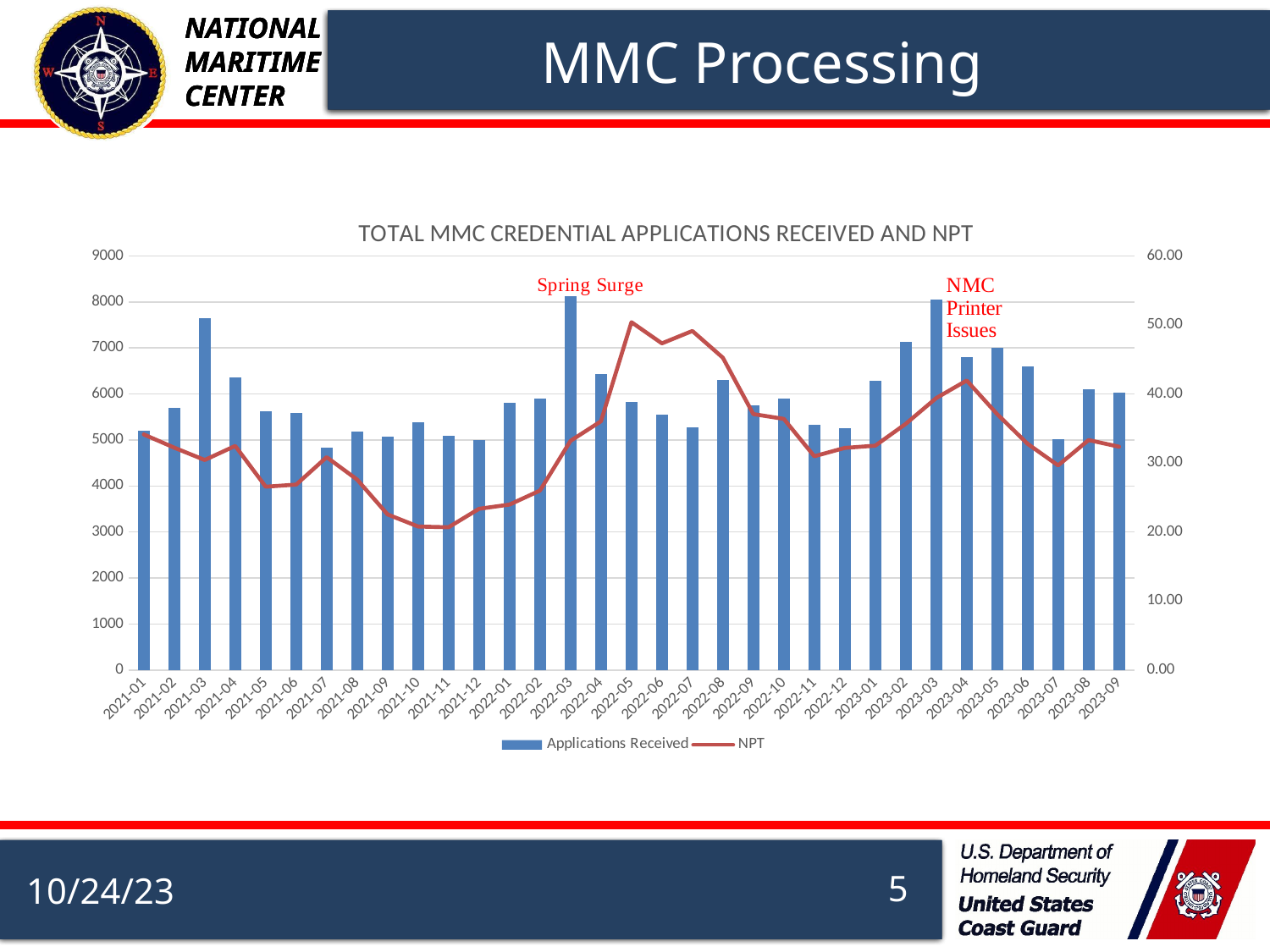
How many months are plotted along the x axis? 33 Which month has more Applications Received, 2022-03 or 2022-04? 2022-03 Does the NPT line rise or fall from 2022-02 to 2022-05? rise Which month has more Applications Received, 2021-02 or 2021-03? 2021-03 Is the NPT value for 2022-05 greater or less than 40.00? greater Is the Applications Received value for 2021-03 greater or less than 7000? greater What is the title of the chart? TOTAL MMC CREDENTIAL APPLICATIONS RECEIVED AND NPT How many series does the chart legend list? 2 Which annotation is placed above the 2022-03 bar? Spring Surge What kind of chart is shown on the slide? Combined bar and line chart Is the Applications Received value for 2021-09 greater or less than 6000? less